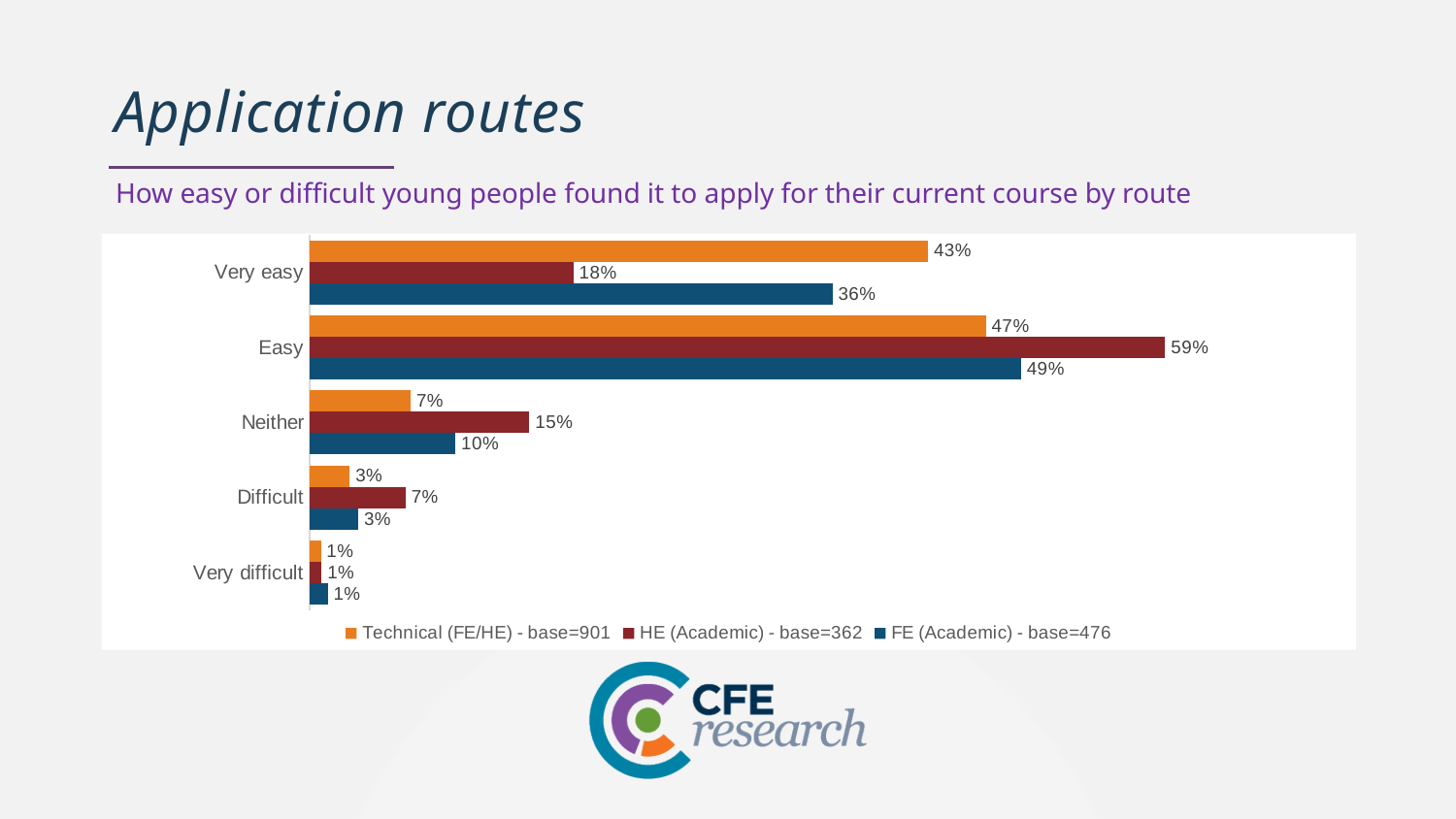
How many series does the legend list? 3 What percentage of Technical (FE/HE) respondents found applying 'Very easy'? 43% Which response category has the highest value for the HE (Academic) series? Easy What is the base (sample size) for the FE (Academic) series shown in the legend? 476 Which response category has the lowest value for the Technical (FE/HE) series? Very difficult For 'Very easy', which is larger: the Technical (FE/HE) value or the FE (Academic) value? Technical (FE/HE) What is the difference between the HE (Academic) and FE (Academic) values for 'Difficult'? 4% How many response categories are shown on the chart? 5 What is the difference between the HE (Academic) and Technical (FE/HE) values for 'Easy'? 12% What percentage of FE (Academic) respondents answered 'Neither'? 10% What type of chart is shown on the slide? Bar chart What percentage of HE (Academic) respondents found applying 'Easy'? 59%